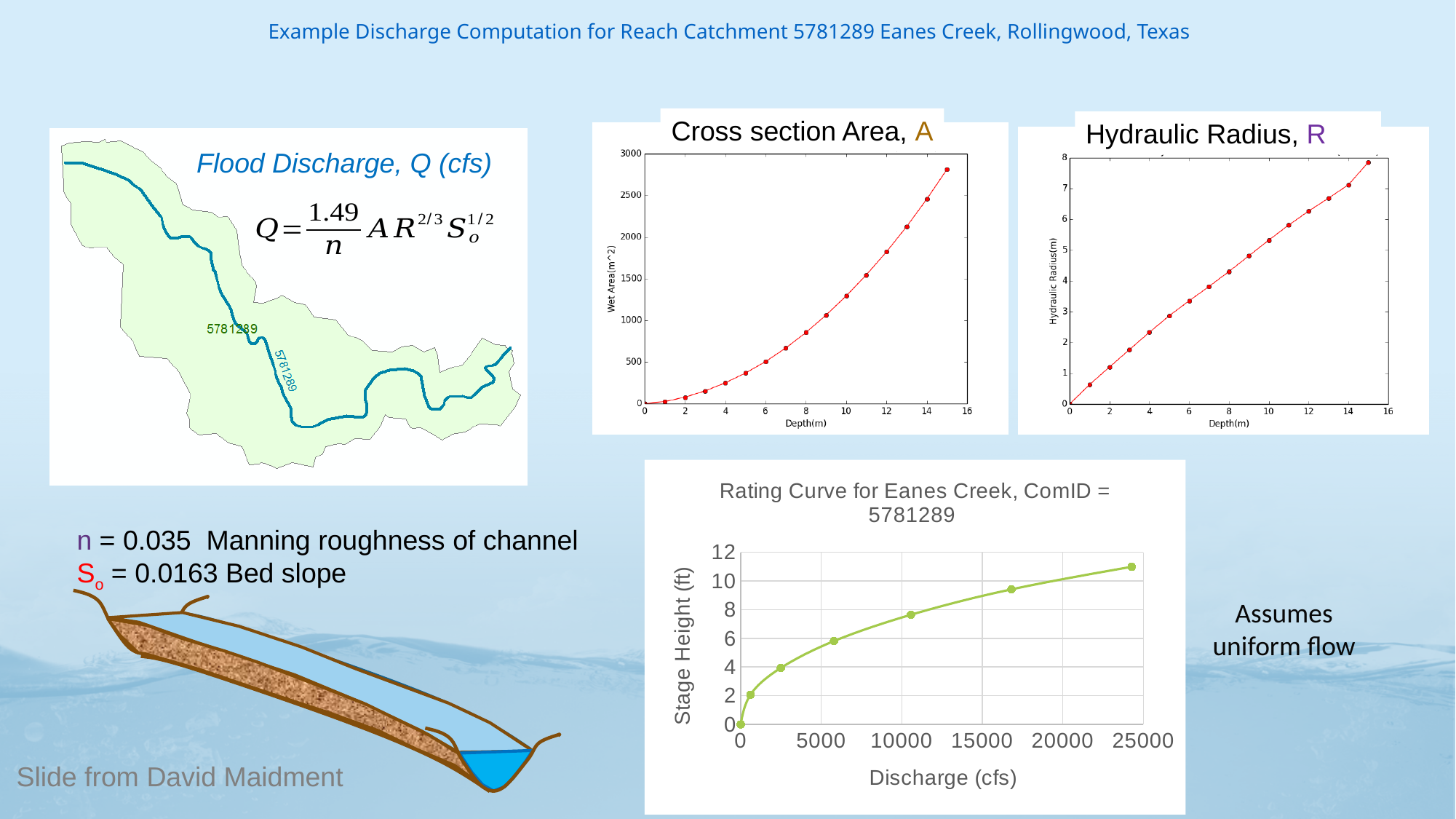
What is the y-axis label of the Rating Curve for Eanes Creek chart? Stage Height (ft) In the Cross section Area, A chart, does the wet area rise or fall as depth increases? rises In the Cross section Area, A chart, is the wet area at a depth of 5 m greater or less than 500? less In the Hydraulic Radius, R chart, is the hydraulic radius at a depth of 15 m greater or less than 7? greater In the Hydraulic Radius, R chart, does the hydraulic radius rise or fall as depth increases? rises In the Cross section Area, A chart, is the wet area at a depth of 15 m greater or less than 2500? greater What kind of chart is the Cross section Area, A chart? line chart In the Rating Curve for Eanes Creek chart, does stage height rise or fall as discharge increases? rises What is the x-axis label of the Hydraulic Radius, R chart? Depth(m) In the Rating Curve for Eanes Creek chart, how many data points are plotted? 7